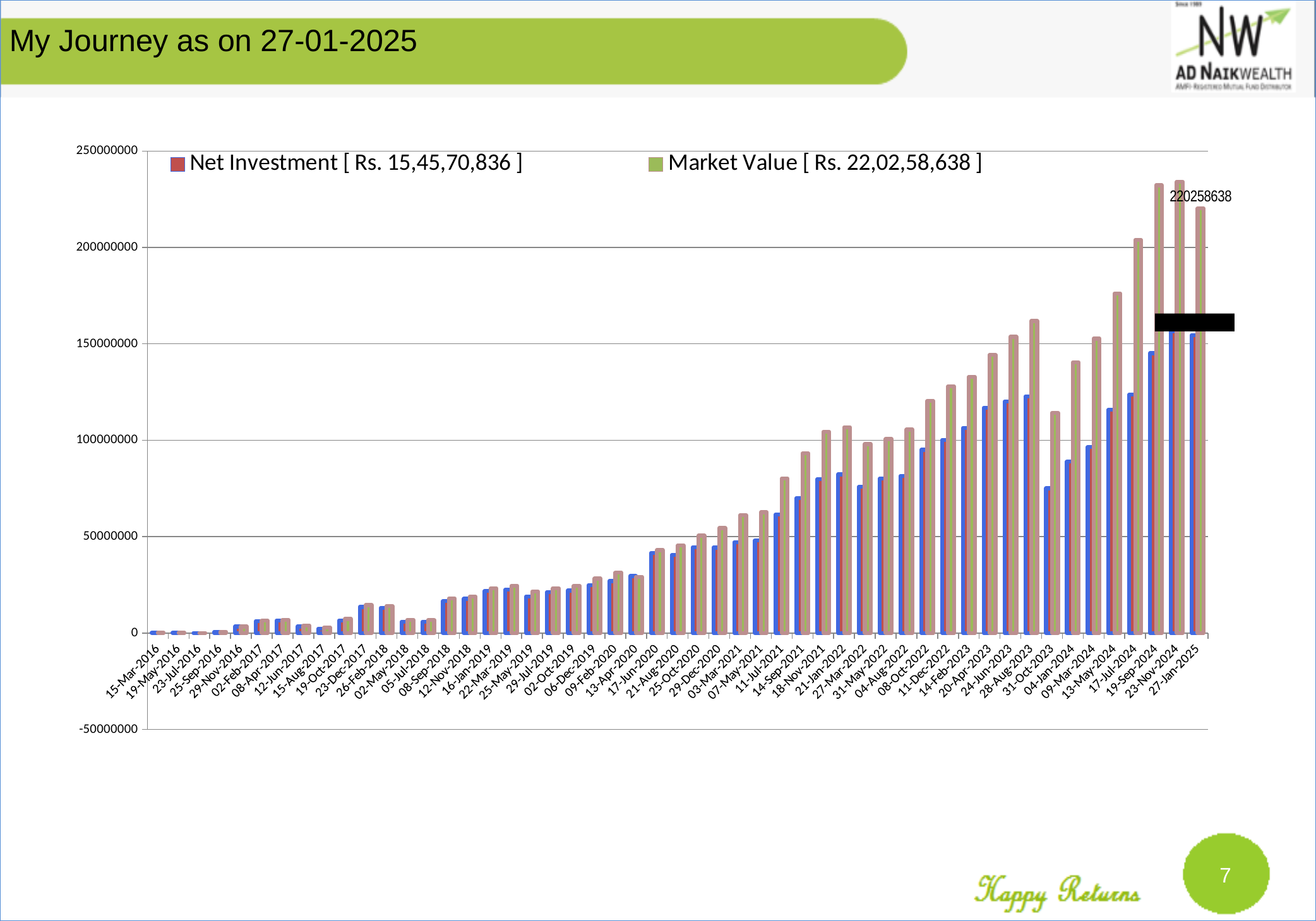
On 27-Jan-2025, which is larger: Net Investment or Market Value? Market Value Does the Net Investment generally rise or fall from 15-Mar-2016 to 27-Jan-2025? rise Is the Market Value for 17-Jun-2020 greater or less than 50000000? less What total is shown in the legend entry for Market Value? Rs. 22,02,58,638 What is the Market Value on 27-Jan-2025 according to the data label? 220258638 Which date has the larger Market Value: 04-Jan-2024 or 13-May-2024? 13-May-2024 How many dates are shown on the x axis? 51 Is the Net Investment for 31-Oct-2023 greater or less than 100000000? less How many series does the legend list? 2 What kind of chart is shown on the slide? bar chart Is the Net Investment for 27-Jan-2025 greater or less than 150000000? greater